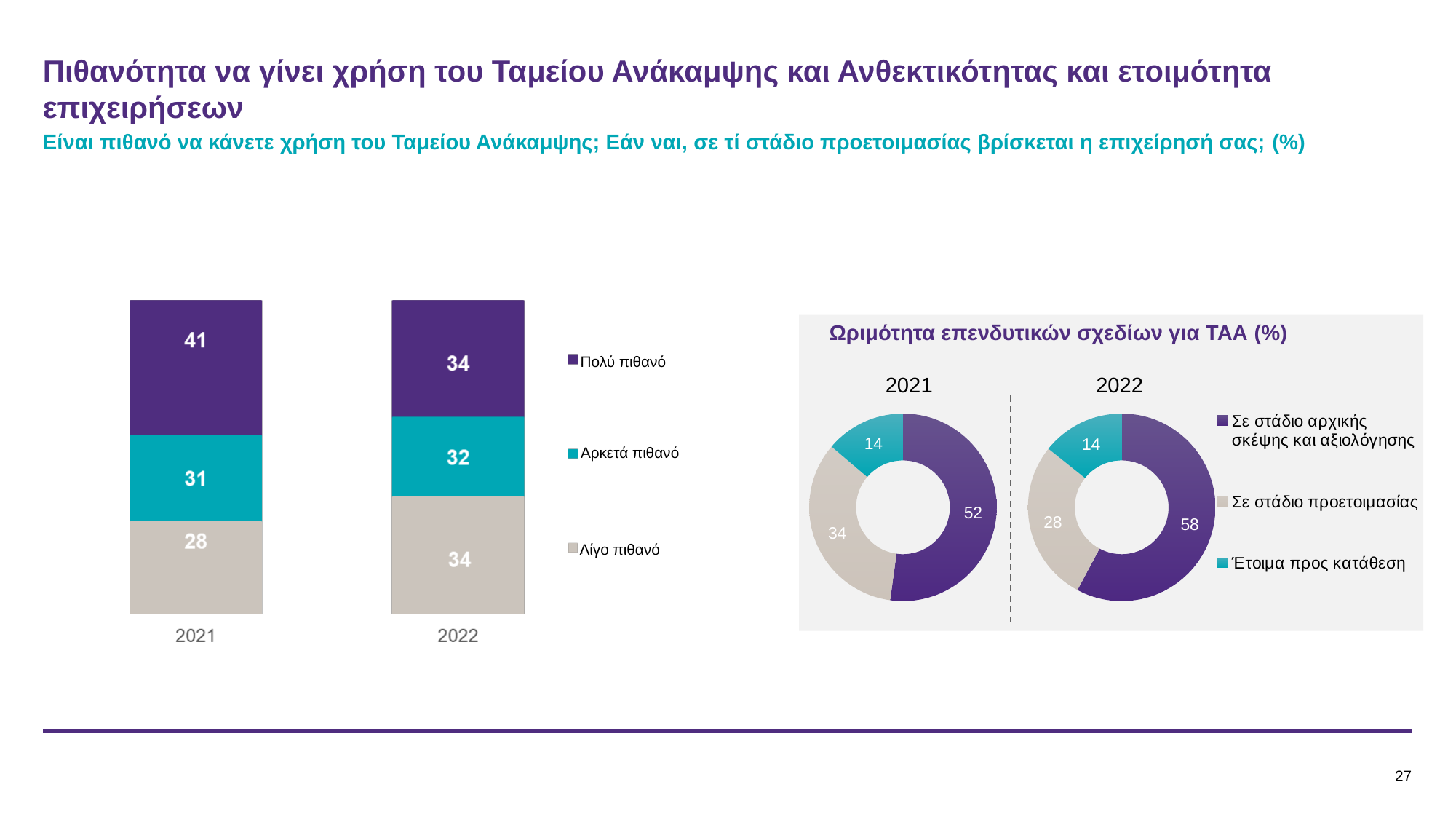
In the stacked bar chart on the left, how many series does the legend list? 3 In the stacked bar chart on the left, which series has the largest value in 2021? Πολύ πιθανό In the stacked bar chart on the left, by how much did the value for Πολύ πιθανό change from 2021 to 2022? 7 In the stacked bar chart on the left, what is the value for Λίγο πιθανό in 2021? 28 In the chart titled 'Ωριμότητα επενδυτικών σχεδίων για ΤΑΑ (%)', what is the difference between Σε στάδιο προετοιμασίας in 2021 and 2022? 6 In the chart titled 'Ωριμότητα επενδυτικών σχεδίων για ΤΑΑ (%)', what is the value for Σε στάδιο προετοιμασίας in 2021? 34 In the stacked bar chart on the left, what is the total of the 2022 bar? 100 In the chart titled 'Ωριμότητα επενδυτικών σχεδίων για ΤΑΑ (%)', what is the value for Σε στάδιο αρχικής σκέψης και αξιολόγησης in 2022? 58 What kind of chart is shown on the left of the slide? Stacked bar chart In the stacked bar chart on the left, what is the value for Πολύ πιθανό in 2021? 41 In the chart titled 'Ωριμότητα επενδυτικών σχεδίων για ΤΑΑ (%)', which category is smallest in 2022? Έτοιμα προς κατάθεση In the stacked bar chart on the left, what is the value for Αρκετά πιθανό in 2022? 32